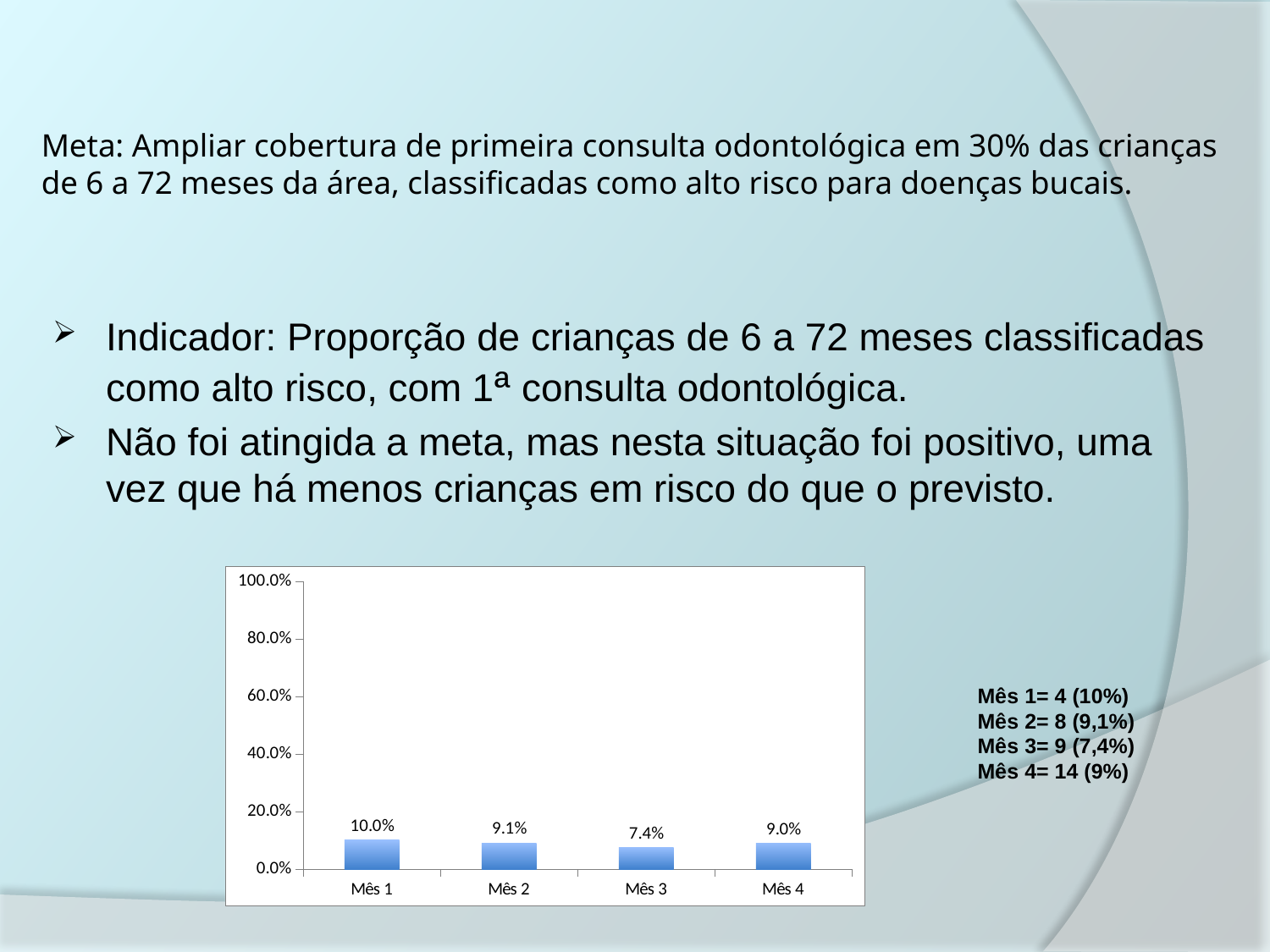
How many months are shown on the x axis? 4 What is the difference between the values for Mês 2 and Mês 4? 0.1% What is the highest value shown on the y axis? 100.0% What is the value for Mês 1? 10.0% Which month has the lowest value? Mês 3 Which is larger, the value for Mês 2 or the value for Mês 4? Mês 2 What is the value for Mês 3? 7.4% What is the difference between the values for Mês 1 and Mês 3? 2.6% Is the value for Mês 1 greater or less than 20.0%? less Which month has the highest value? Mês 1 What is the value for Mês 4? 9.0% What kind of chart is shown on the slide? bar chart